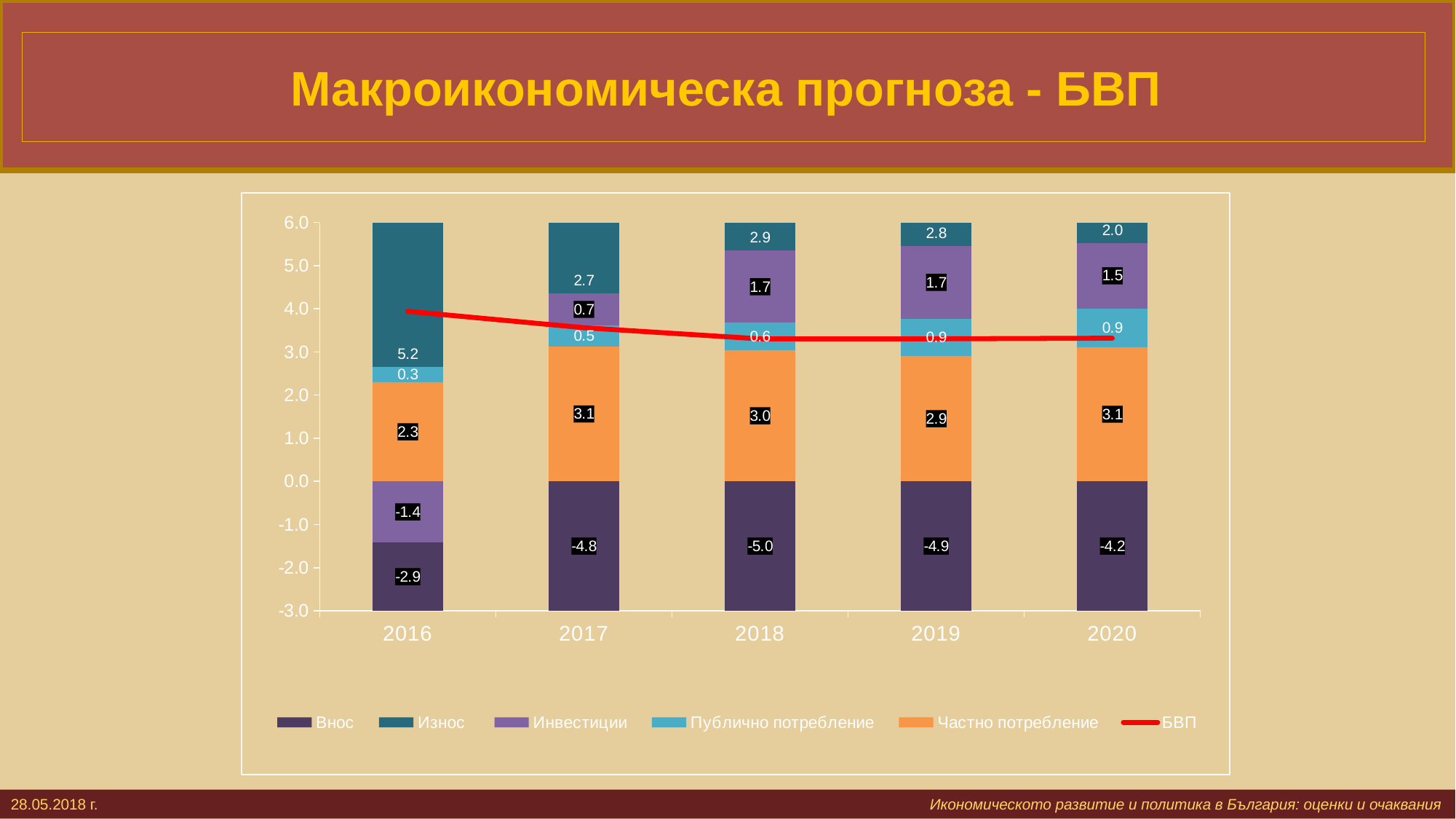
Which is larger, Инвестиции in 2017 or Инвестиции in 2020? 2020 What is the value of Публично потребление for 2020? 0.9 What is the value of Износ for 2016? 5.2 How many years are shown on the x axis? 5 What is the value of Внос for 2018? -5.0 What kind of chart is shown on the slide? Stacked bar chart with a line In which year is the Износ value highest? 2016 What is the difference between Частно потребление in 2017 and in 2019? 0.2 In which year is the Внос value lowest (most negative)? 2018 What is the value of Инвестиции for 2019? 1.7 How many series does the legend list? 6 Is the БВП line value for 2016 greater or less than 3.0? greater